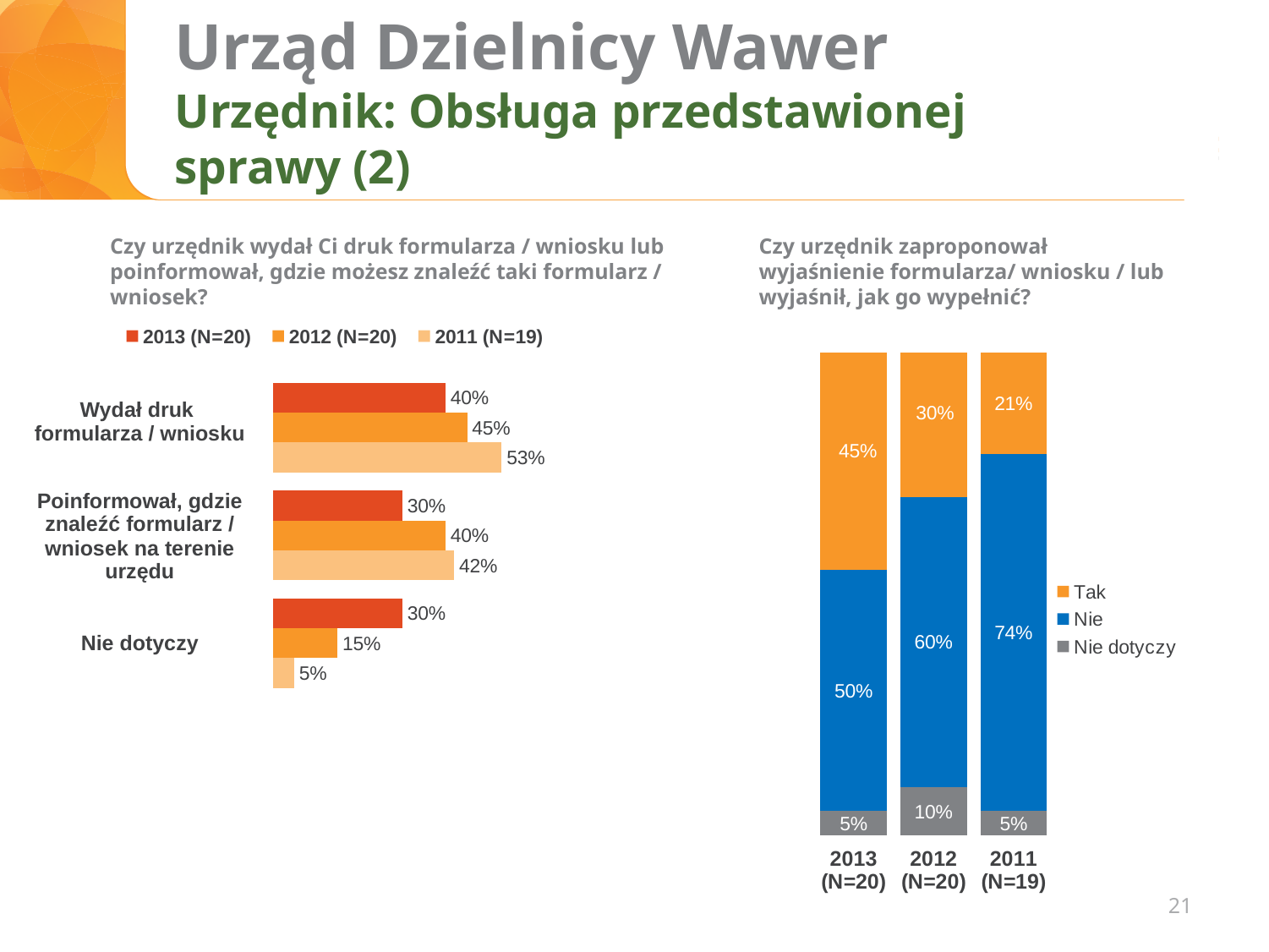
In the left chart, how many series does the legend list? 3 In the right chart, what is the total of the stacked bar for 2012 (N=20)? 100% In the right chart, which year has the lowest 'Tak' value? 2011 (N=19) In the right chart, what is the 'Tak' value for 2013 (N=20)? 45% In the left chart, which year has the highest value for 'Nie dotyczy'? 2013 (N=20) In the left chart, what is the value for 'Nie dotyczy' in 2012 (N=20)? 15% In the right chart, what is the 'Nie' value for 2011 (N=19)? 74% In the left chart, what is the difference between the 2011 and 2013 values for 'Wydał druk formularza / wniosku'? 13% In the right chart, is the 'Nie' value for 2012 (N=20) larger or smaller than the 'Nie' value for 2013 (N=20)? Larger What kind of chart is the left chart? Bar chart In the left chart, what is the value for 'Wydał druk formularza / wniosku' in 2011 (N=19)? 53% In the left chart, how many categories are shown on the vertical axis? 3